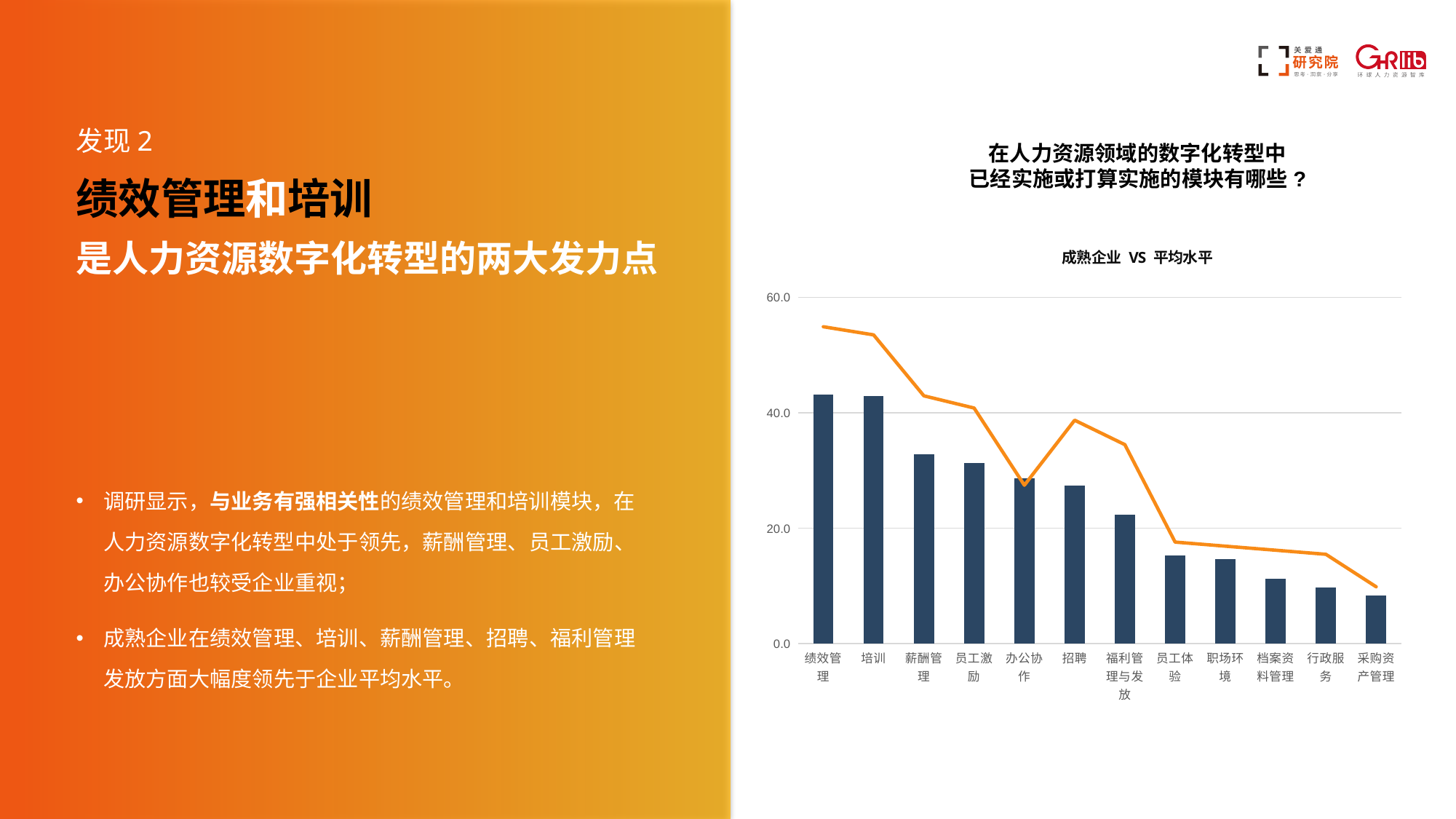
Is the line value for 员工体验 greater or less than 20? less Is the bar value for 招聘 greater or less than 20? greater Which has the higher bar, 招聘 or 员工体验? 招聘 What is the subtitle shown directly above the chart? 成熟企业 VS 平均水平 Is the line value for 绩效管理 greater or less than 40? greater What kind of chart is shown on the slide? A bar chart with a line overlay Do the bar values generally rise or fall from left to right along the x axis? fall How many categories are shown along the x axis of the chart? 12 Which category has the lowest bar in the chart? 采购资产管理